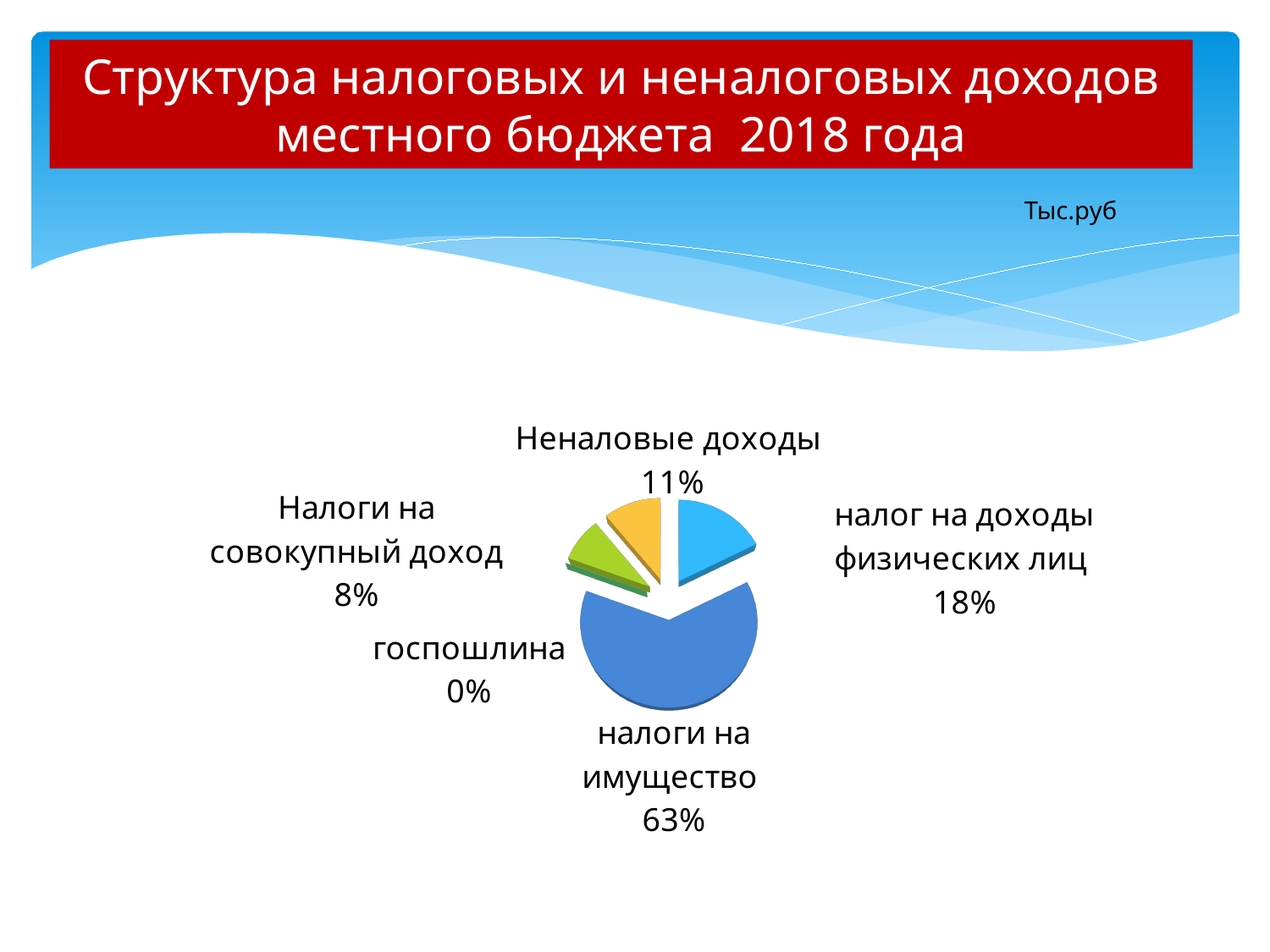
Which category has the largest share of the pie? налоги на имущество What share of the pie does 'Неналовые доходы' have? 11% Which is larger: 'Неналовые доходы' or 'Налоги на совокупный доход'? Неналовые доходы What unit is indicated on the slide above the chart? Тыс.руб Which category has the smallest share of the pie? госпошлина What is the difference in percentage points between 'налоги на имущество' and 'налог на доходы физических лиц'? 45 What share of the pie does 'Налоги на совокупный доход' have? 8% What share of the pie does 'госпошлина' have? 0% How many categories are shown in the pie chart? 5 What kind of chart is shown on the slide? Pie chart